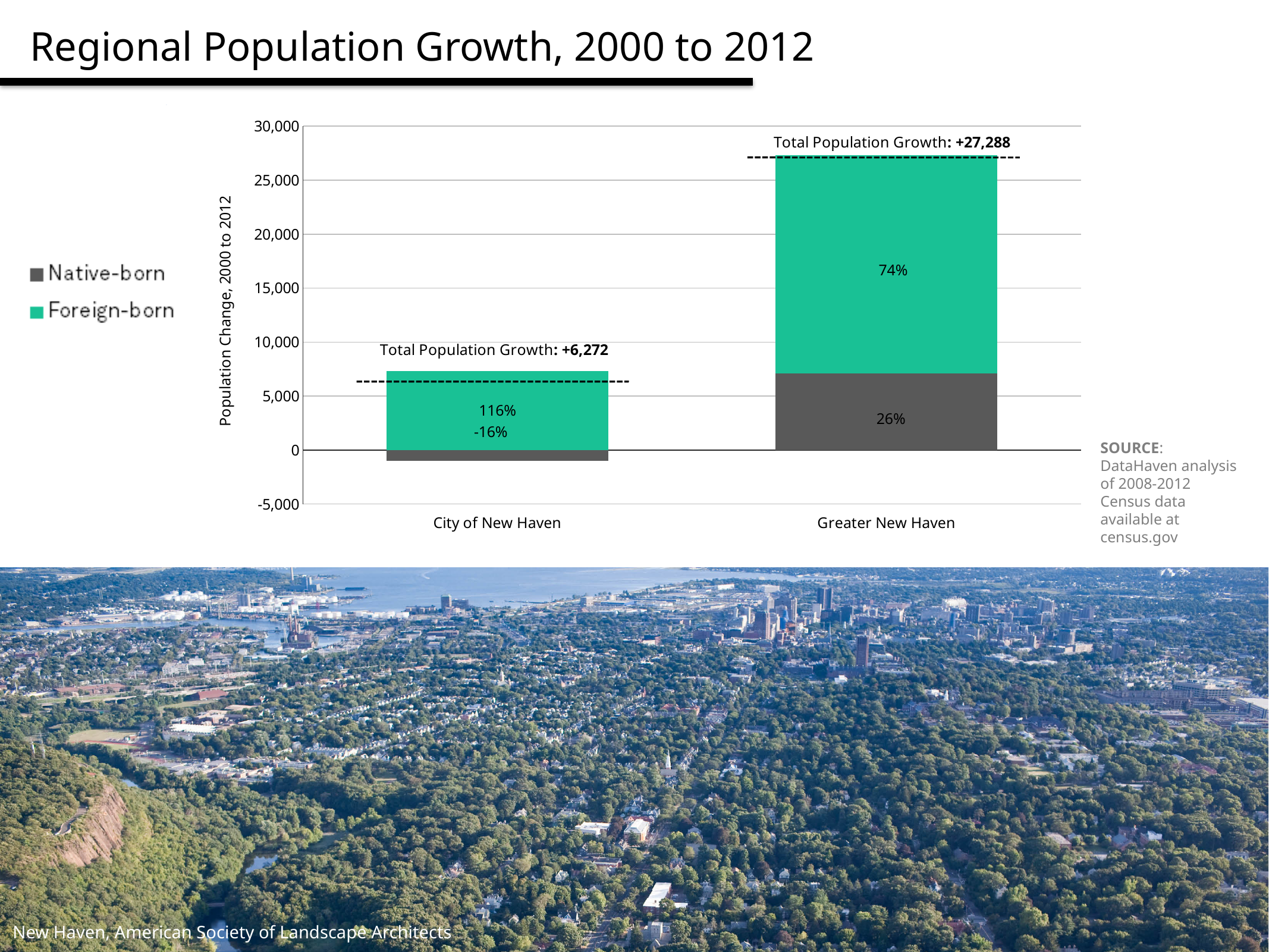
Is the Native-born value for Greater New Haven greater or less than 5,000? greater What percentage label is shown for the Native-born segment of the City of New Haven bar? -16% What kind of chart is shown on the slide? Stacked bar chart What is the total population growth shown for the City of New Haven? +6,272 What is the difference between the total population growth of Greater New Haven and the City of New Haven? 21,016 How many series does the legend list? 2 What percentage label is shown for the Foreign-born segment of the City of New Haven bar? 116% What percentage label is shown on the Foreign-born segment for Greater New Haven? 74% Which area has the larger total population growth, City of New Haven or Greater New Haven? Greater New Haven What is the total population growth shown for Greater New Haven? +27,288 Is the Native-born value for the City of New Haven greater or less than 0? less What percentage label is shown on the Native-born segment for Greater New Haven? 26%